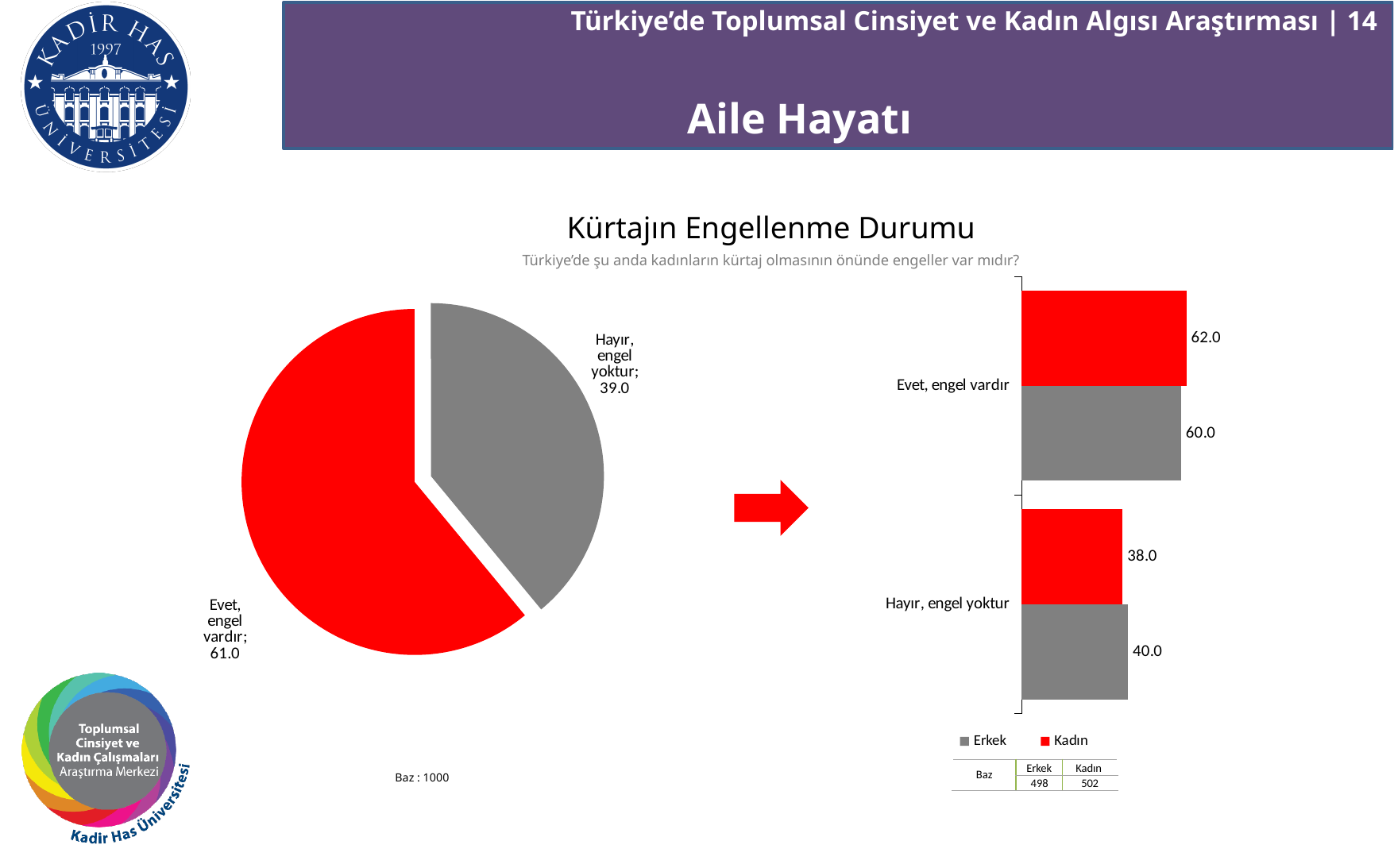
In the pie chart on the left, which slice is the largest? Evet, engel vardır In the pie chart on the left, what is the difference between the "Evet, engel vardır" and "Hayır, engel yoktur" values? 22.0 In the pie chart on the left, what is the value for "Hayır, engel yoktur"? 39.0 What kind of chart is the chart on the right of the slide? Bar chart How many series does the legend of the bar chart on the right list? 2 In the bar chart on the right, what is the difference between the Erkek and Kadın values for "Hayır, engel yoktur"? 2.0 In the bar chart on the right, what is the Erkek value for "Hayır, engel yoktur"? 40.0 In the bar chart on the right, what is the Kadın value for "Evet, engel vardır"? 62.0 In the pie chart on the left, what is the value for "Evet, engel vardır"? 61.0 In the bar chart on the right, which is larger for "Evet, engel vardır": the Erkek value or the Kadın value? Kadın In the bar chart on the right, which colour represents the Kadın series? Red What kind of chart is the chart on the left of the slide? Pie chart